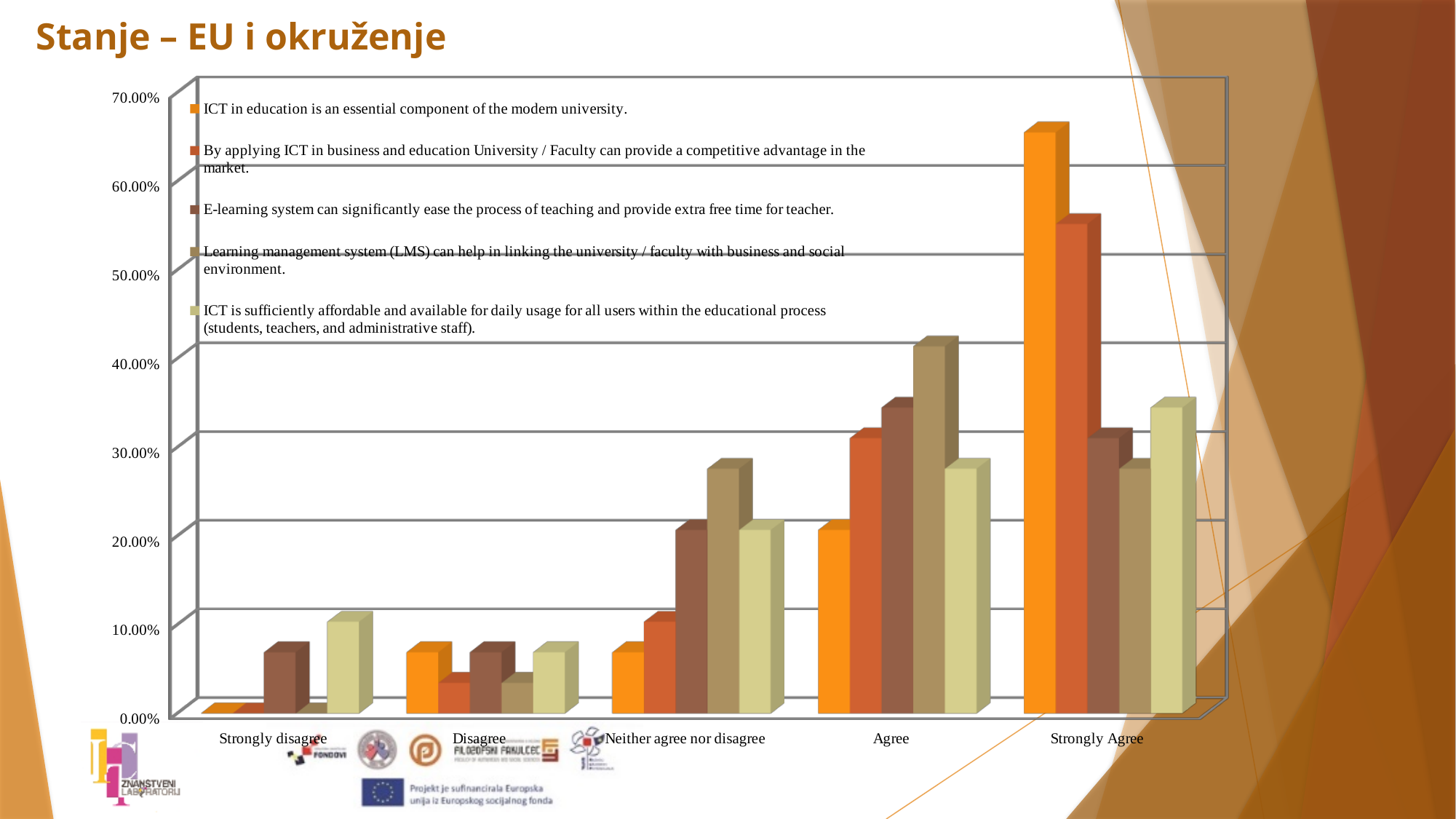
Do the values for "ICT in education is an essential component of the modern university." rise or fall from Strongly disagree to Strongly Agree? rise Is the value for Neither agree nor disagree in the series "E-learning system can significantly ease the process of teaching and provide extra free time for teacher." greater or less than 10.00%? greater How many response categories are shown on the x axis? 5 How many series does the legend list? 5 For Agree, which is larger: the value for "Learning management system (LMS) can help in linking the university / faculty with business and social environment." or the value for "ICT in education is an essential component of the modern university."? Learning management system (LMS) can help in linking the university / faculty with business and social environment. Is the value for Strongly Agree in the series "ICT in education is an essential component of the modern university." greater or less than 60.00%? greater For the series "ICT in education is an essential component of the modern university.", which category has the highest value? Strongly Agree Is the value for Agree in the series "Learning management system (LMS) can help in linking the university / faculty with business and social environment." greater or less than 30.00%? greater For Strongly Agree, which is larger: the value for "ICT in education is an essential component of the modern university." or the value for "By applying ICT in business and education University / Faculty can provide a competitive advantage in the market."? ICT in education is an essential component of the modern university. Which series is listed first in the legend? ICT in education is an essential component of the modern university. What kind of chart is shown on the slide? bar chart